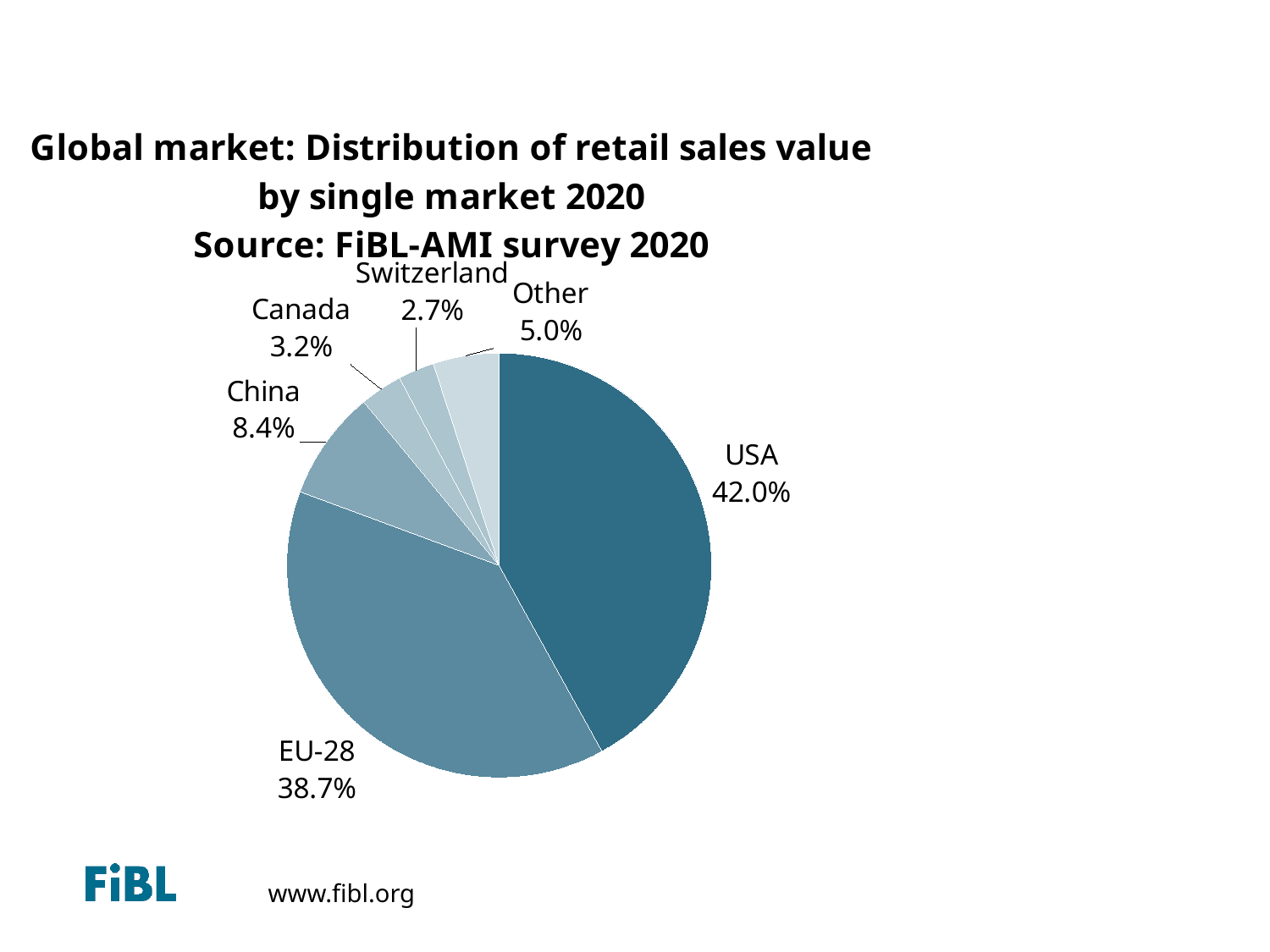
Which market has the largest share of retail sales value? USA What share of retail sales value does the EU-28 hold? 38.7% What share of retail sales value does Switzerland hold? 2.7% What is the difference in share between the USA and the EU-28? 3.3% What kind of chart is shown on the slide? Pie chart What share of retail sales value does China hold? 8.4% Which market has the smallest share of retail sales value? Switzerland What is the source given in the chart title? FiBL-AMI survey 2020 What is the combined share of Canada and Switzerland? 5.9% What share of retail sales value does the USA hold? 42.0% Which has a larger share, Canada or China? China How many slices does the pie chart have? 6